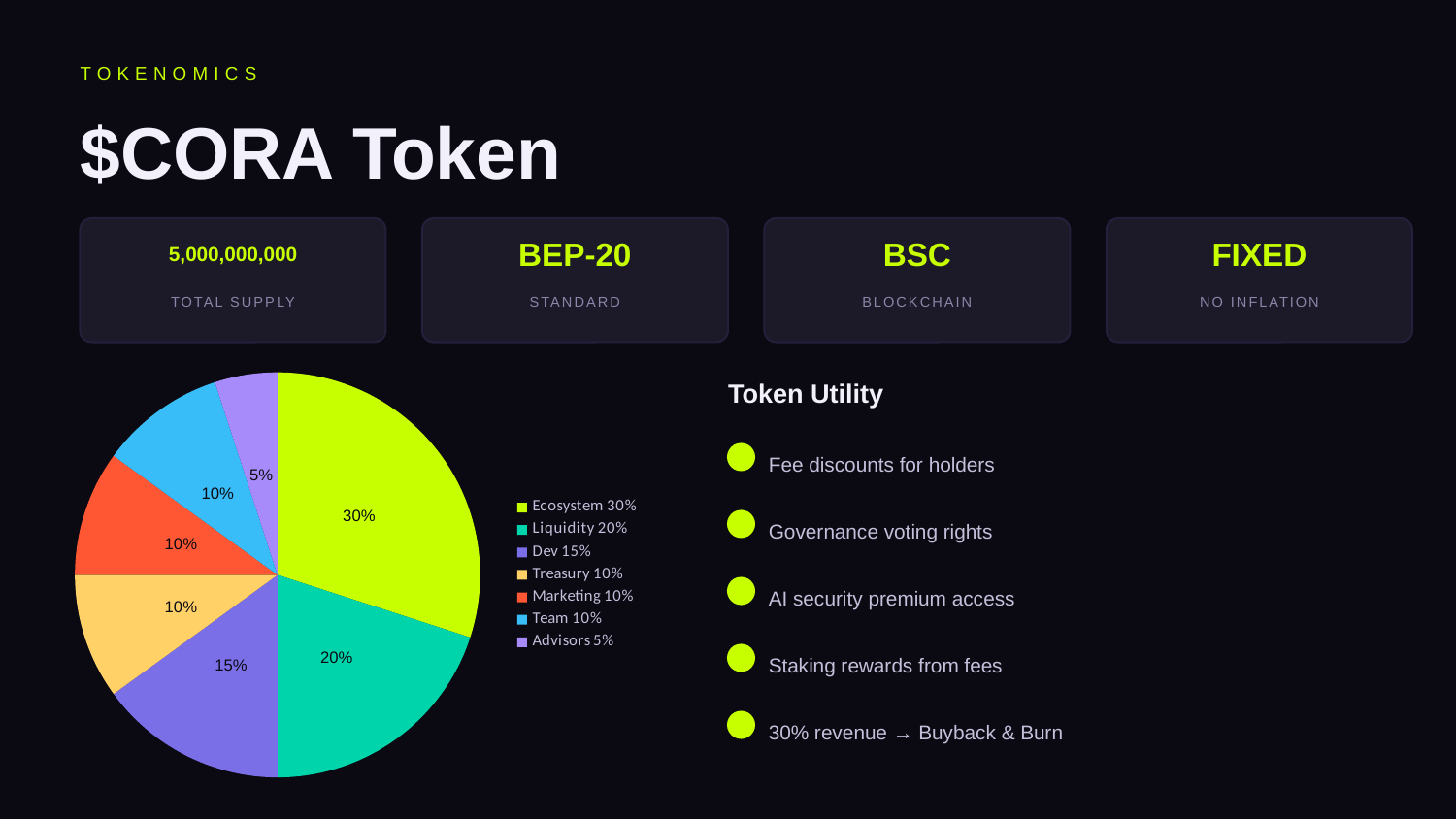
Which is larger, the Dev slice or the Treasury slice? Dev What share of the pie does Ecosystem have? 30% What kind of chart is shown on the slide? pie chart What share of the pie does Advisors have? 5% What is the combined share of Treasury, Marketing and Team? 30% Which category has the largest slice of the pie? Ecosystem What share of the pie does Liquidity have? 20% Which category has the smallest slice of the pie? Advisors What colour is the Ecosystem slice in the pie chart? yellow-green What is the difference in percentage points between Ecosystem and Liquidity? 10% What share of the pie does Dev have? 15% How many categories does the pie chart have? 7